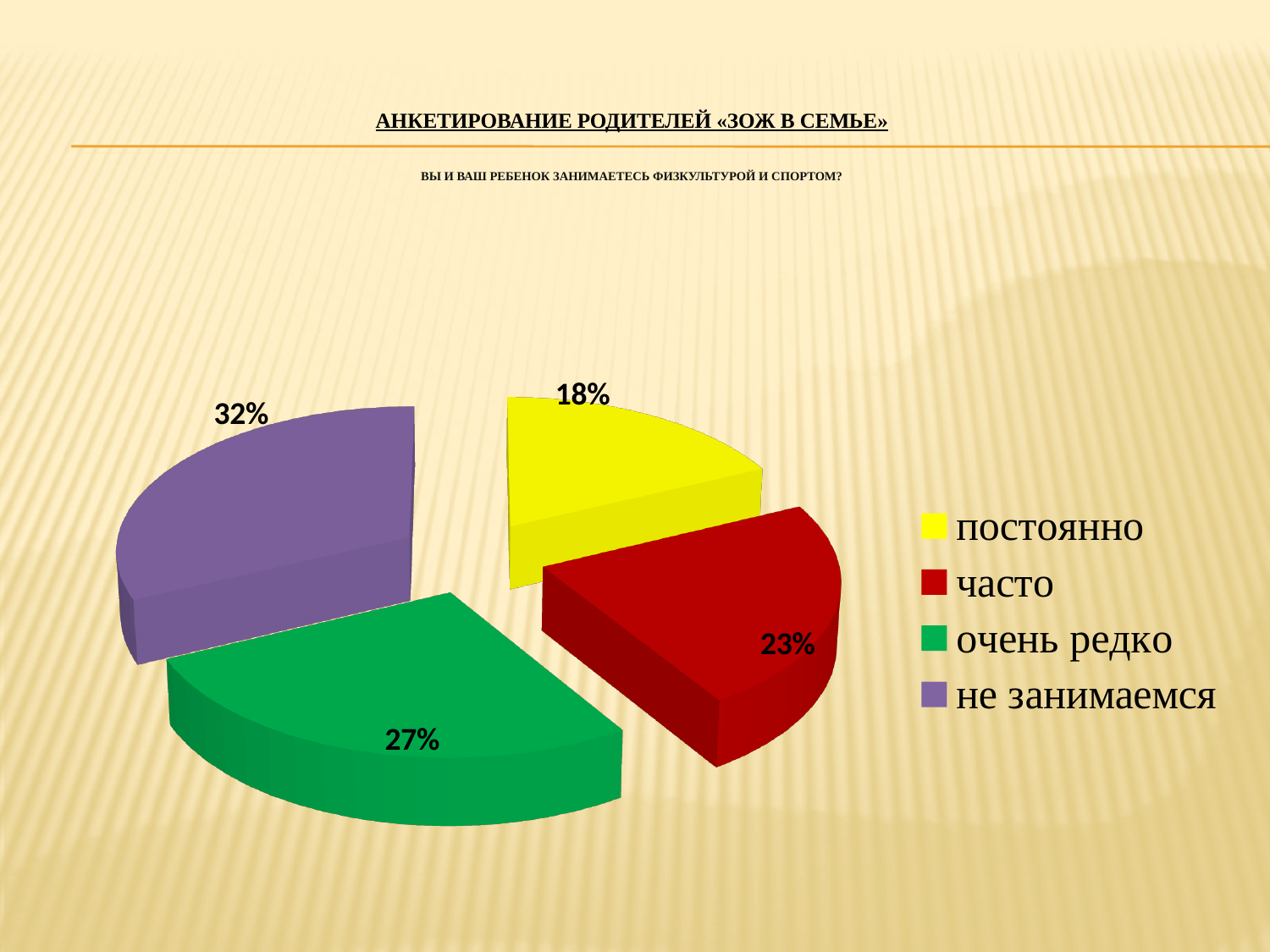
What kind of chart is shown on the slide? pie chart What is the difference in percentage points between "не занимаемся" and "постоянно"? 14 How many categories does the pie chart show? 4 Which category has the smallest share of the pie? постоянно What question is the chart answering, according to the subtitle? ВЫ И ВАШ РЕБЕНОК ЗАНИМАЕТЕСЬ ФИЗКУЛЬТУРОЙ И СПОРТОМ? What percentage of the pie is labelled "очень редко"? 27% What percentage of the pie is labelled "не занимаемся"? 32% Which category has the largest share of the pie? не занимаемся What percentage of the pie is labelled "постоянно"? 18% What percentage of the pie is labelled "часто"? 23% Which is larger, the share for "часто" or the share for "очень редко"? очень редко What colour is the slice for "часто"? red